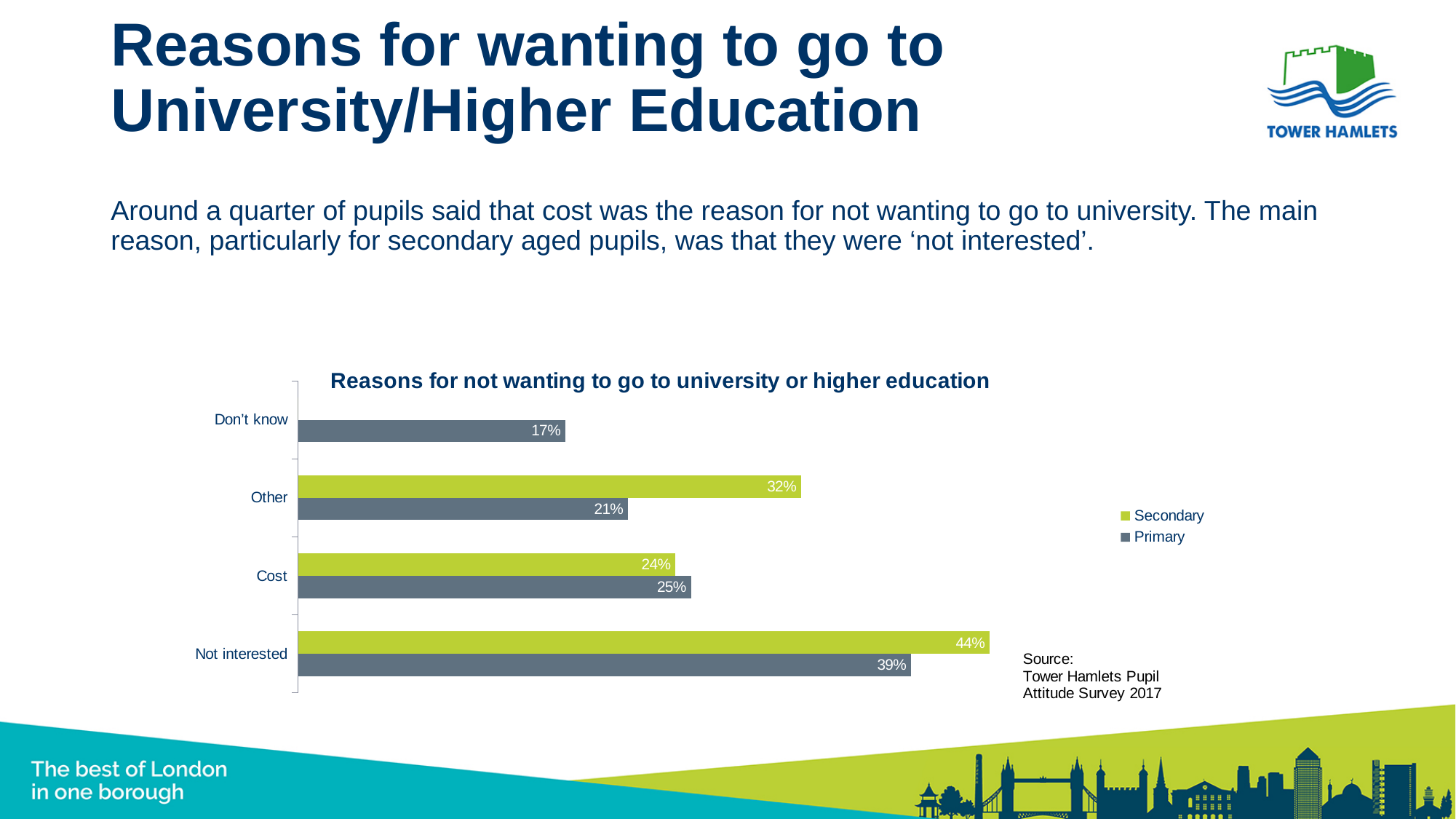
What kind of chart is shown on the slide? Bar chart What is the Secondary value for 'Other'? 32% How many series does the legend list? 2 What is the Primary value for 'Cost'? 25% Which category has the lowest Primary value? Don't know Which category has the highest Primary value? Not interested What is the Primary value for 'Don't know'? 17% What is the difference between the Secondary and Primary values for 'Not interested'? 5% What is the difference between the Secondary and Primary values for 'Other'? 11% Which is larger for 'Other': the Secondary value or the Primary value? Secondary What is the Secondary value for 'Not interested'? 44% How many categories are shown on the chart? 4